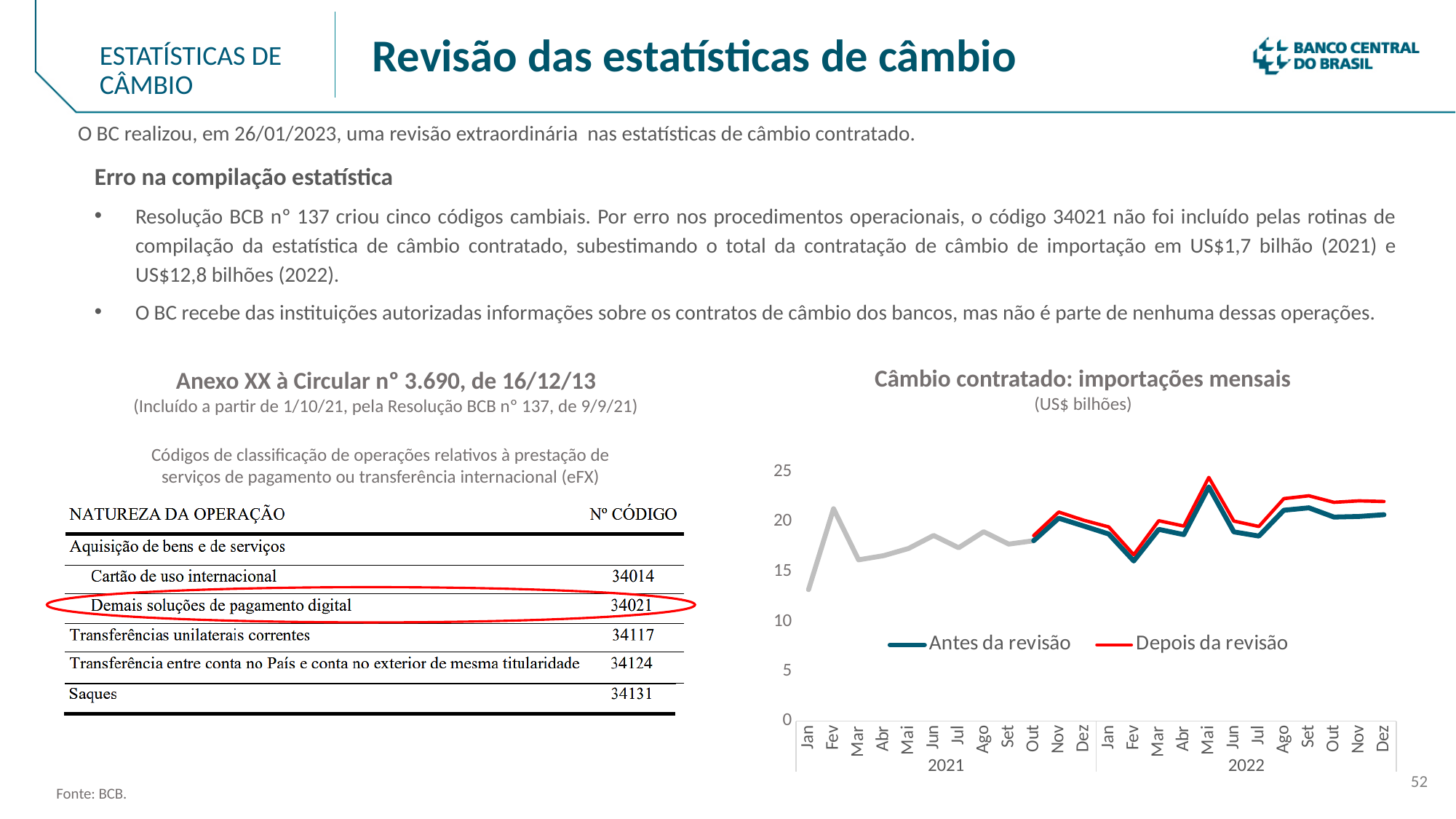
What kind of chart is shown on the slide? line chart Is the 'Depois da revisão' value for Mai 2022 greater or less than 20? greater Does the 'Depois da revisão' series rise or fall from Fev 2022 to Mai 2022? rise In which month does the 'Depois da revisão' series reach its highest value? Mai 2022 How many series does the chart legend list? 2 Is the 'Antes da revisão' value for Fev 2022 greater or less than 20? less What unit is given under the chart title? US$ bilhões What are the two series named in the chart legend? Antes da revisão and Depois da revisão How many months are shown along the x axis of the chart? 24 In Dez 2022, which series has the higher value, 'Antes da revisão' or 'Depois da revisão'? Depois da revisão In which month does the 'Antes da revisão' series reach its lowest value? Fev 2022 Is the value for Jan 2021 greater or less than 15? less